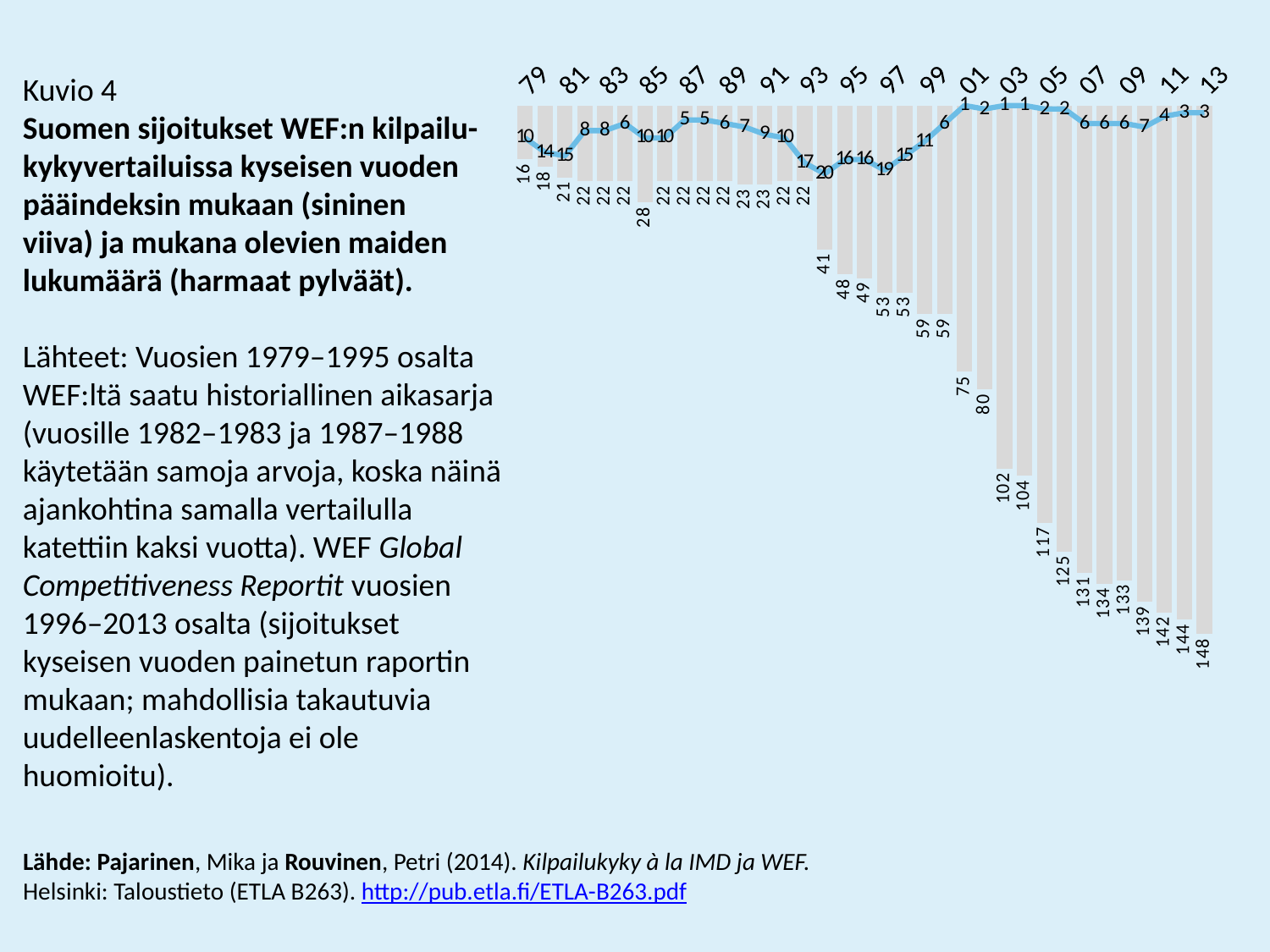
In which year is the number of countries (grey bar) lowest? 1979 What was Finland's ranking (blue line) in 1979? 10 How many countries (grey bar) were included in the WEF comparison in 1979? 16 What is the worst (highest-numbered) ranking Finland reached on the blue line? 20 What is the difference between the number of countries in 2013 and in 1979? 132 How many countries (grey bar) were included in the WEF comparison in 2013? 148 What was Finland's ranking (blue line) in 2001? 1 How many countries (grey bar) were included in 1985? 28 What kind of chart is shown on the slide? combined bar and line chart Does the number of countries (grey bars) generally rise or fall from 1979 to 2013? rise In which year is the number of countries (grey bar) highest? 2013 Which year had more countries in the comparison, 2003 or 2005? 2005